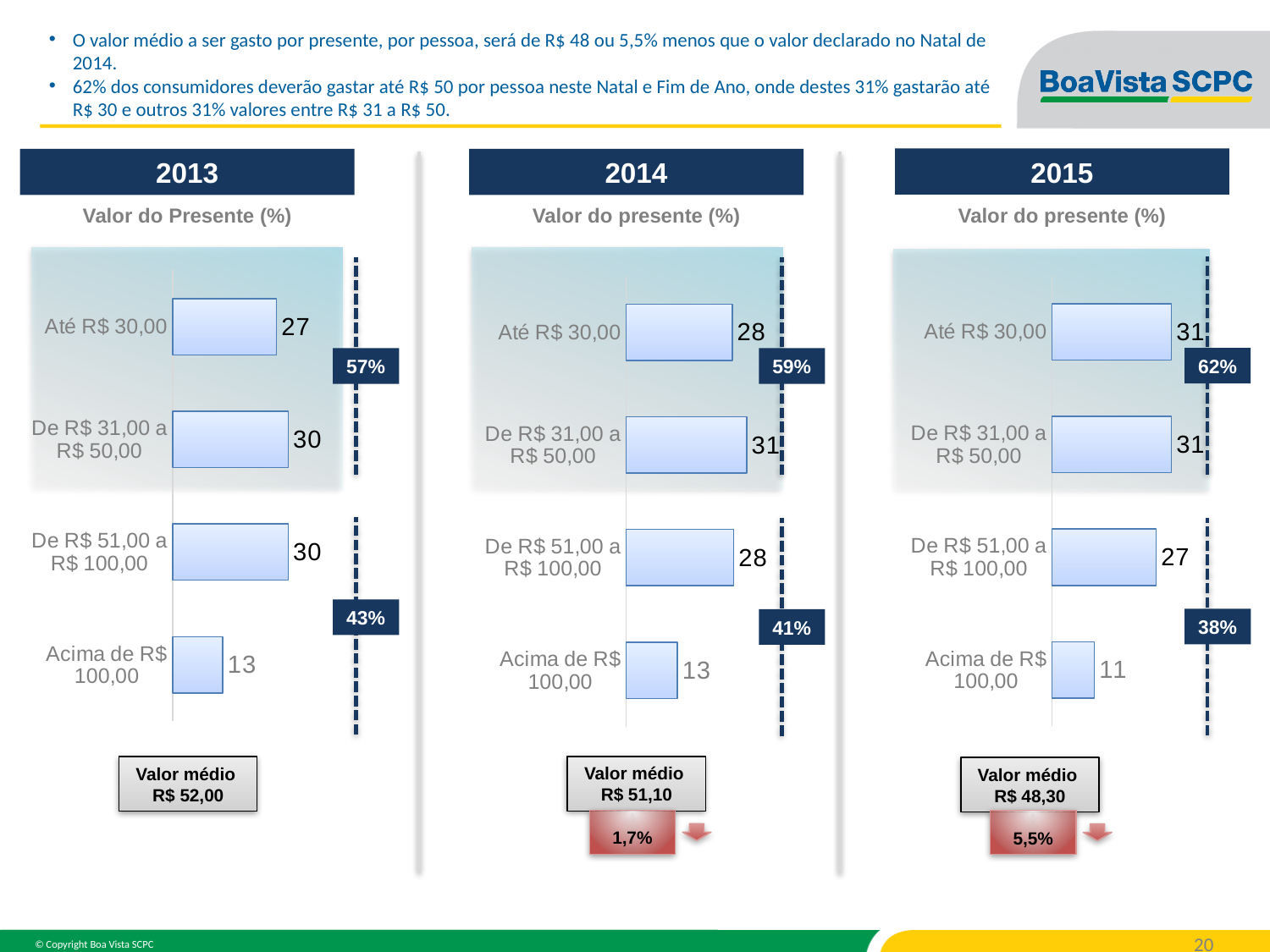
In the 2015 chart, what is the value for 'Acima de R$ 100,00'? 11 In the 2015 chart, which is larger: 'Até R$ 30,00' or 'De R$ 51,00 a R$ 100,00'? Até R$ 30,00 In the 2013 chart, what is the value for 'Até R$ 30,00'? 27 How many categories does the 2014 chart show? 4 In the 2013 chart, what is the difference between 'De R$ 31,00 a R$ 50,00' and 'Acima de R$ 100,00'? 17 What type of chart is used for the 2013 'Valor do Presente (%)' data? Bar chart In the 2015 chart, which category has the lowest value? Acima de R$ 100,00 In the 2014 chart, which category has the highest value? De R$ 31,00 a R$ 50,00 In the 2014 chart, what is the combined share shown for 'De R$ 51,00 a R$ 100,00' and 'Acima de R$ 100,00'? 41% What is the 'Valor médio' shown below the 2015 chart? R$ 48,30 In the 2014 chart, what is the value for 'De R$ 31,00 a R$ 50,00'? 31 In the 2015 chart, what is the combined share shown for the two lowest price ranges (up to R$ 50,00)? 62%